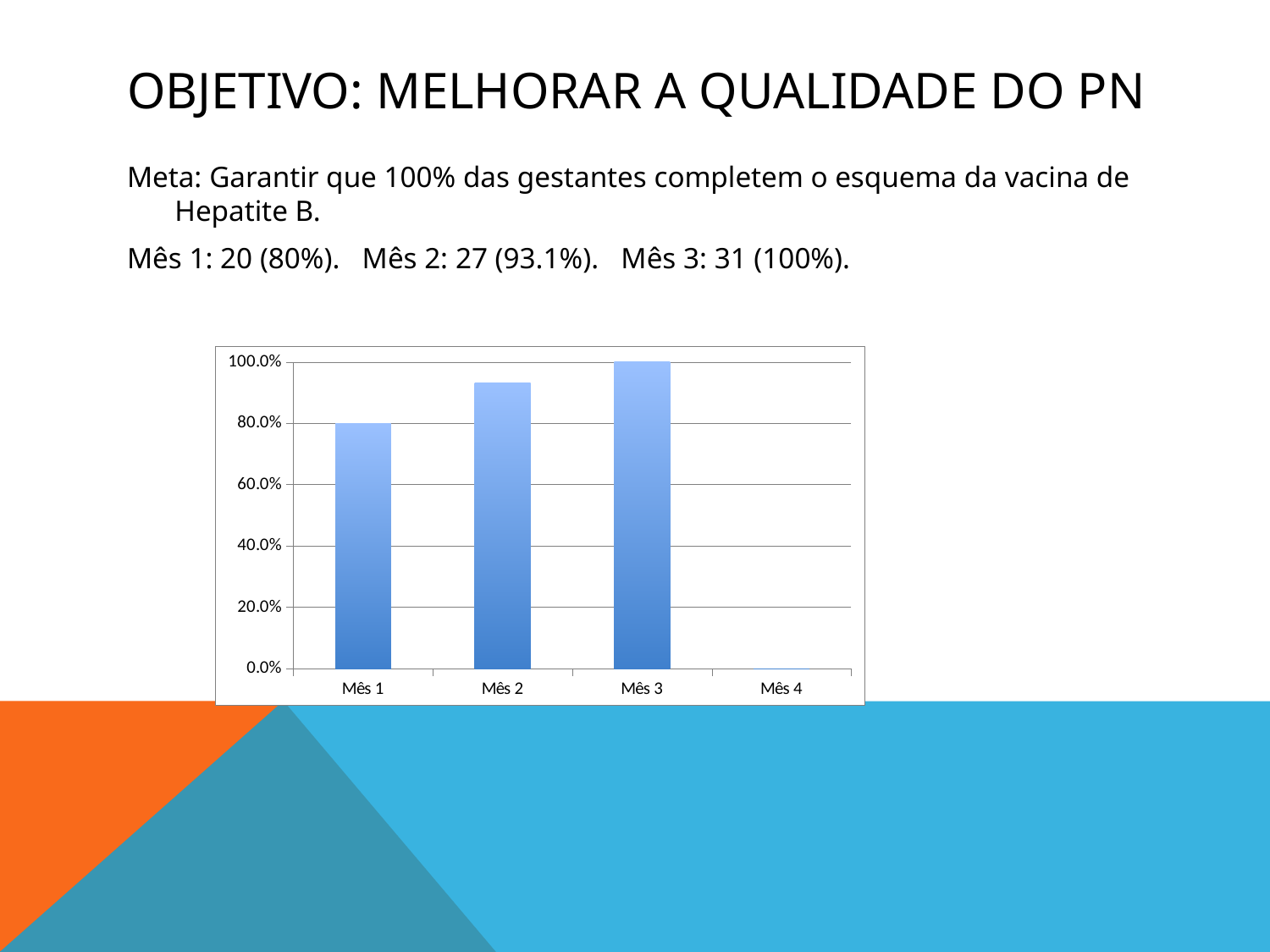
How many categories are shown on the x axis of the chart? 4 Which is larger, the value for Mês 2 or the value for Mês 1? Mês 2 What is the difference between the values for Mês 3 and Mês 1? 20.0% Which month has the lowest bar in the chart? Mês 4 What is the value for Mês 3 in the bar chart? 100.0% Which month has the highest bar in the chart? Mês 3 Is the value for Mês 2 greater or less than 80.0%? greater Is the value for Mês 4 greater or less than 20.0%? less Do the values rise or fall from Mês 1 to Mês 3? rise What kind of chart is shown on the slide? bar chart What is the value for Mês 1 in the bar chart? 80.0% What is the value for Mês 2 in the bar chart? 93.1%